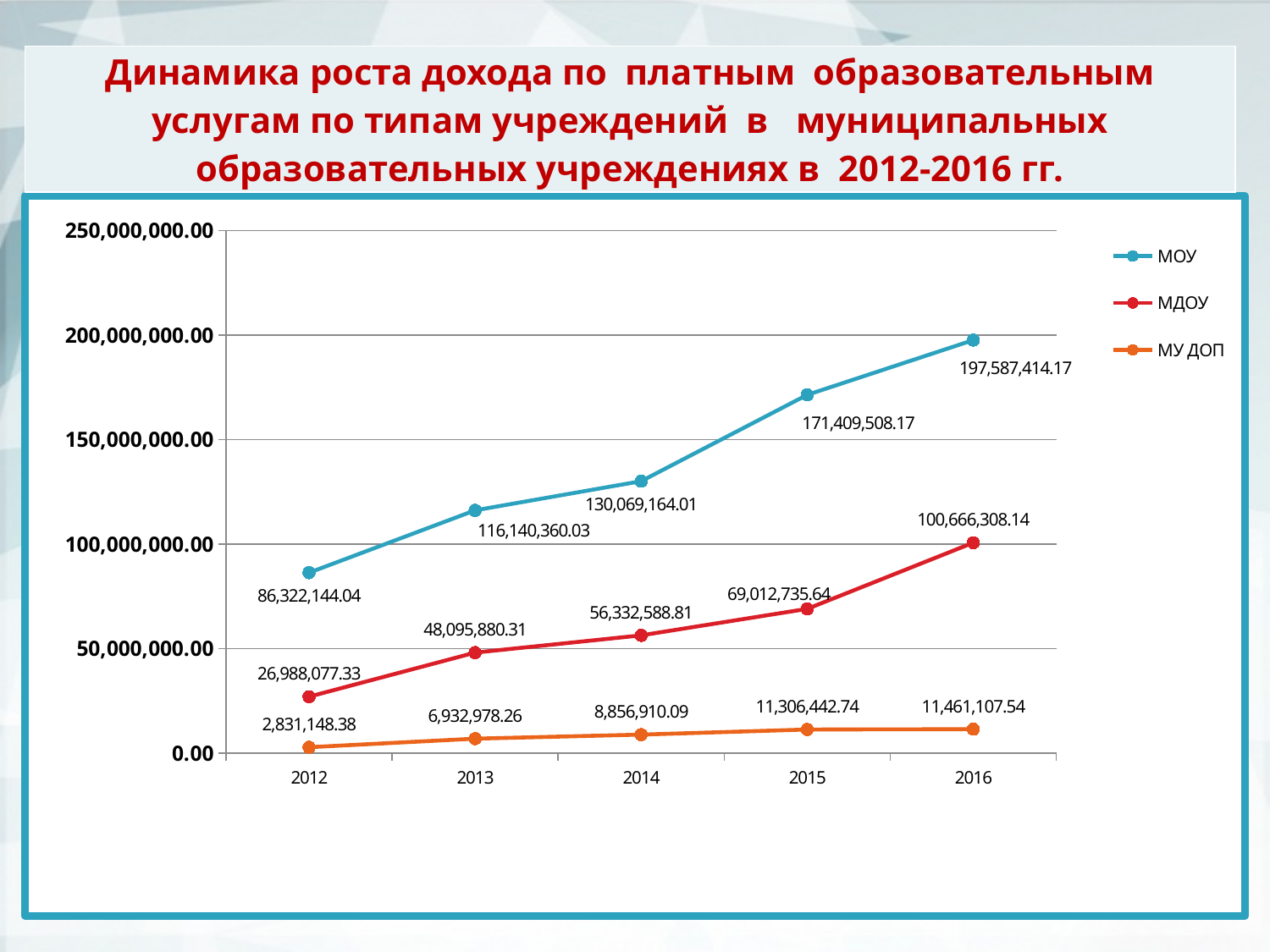
What is the value for МУ ДОП in 2014? 8,856,910.09 How many years are shown on the x axis? 5 Which is larger in 2015: the value for МОУ or the value for МДОУ? МОУ In which year is the value for МДОУ highest? 2016 In which year is the value for МОУ lowest? 2012 How many series does the legend list? 3 Does the МОУ series rise or fall from 2012 to 2016? rise What is the value for МОУ in 2016? 197,587,414.17 Is the value for МДОУ in 2016 greater or less than 100,000,000.00? greater What is the difference between the МОУ values in 2016 and 2012? 111,265,270.13 What is the value for МДОУ in 2013? 48,095,880.31 What type of chart is shown on the slide? line chart